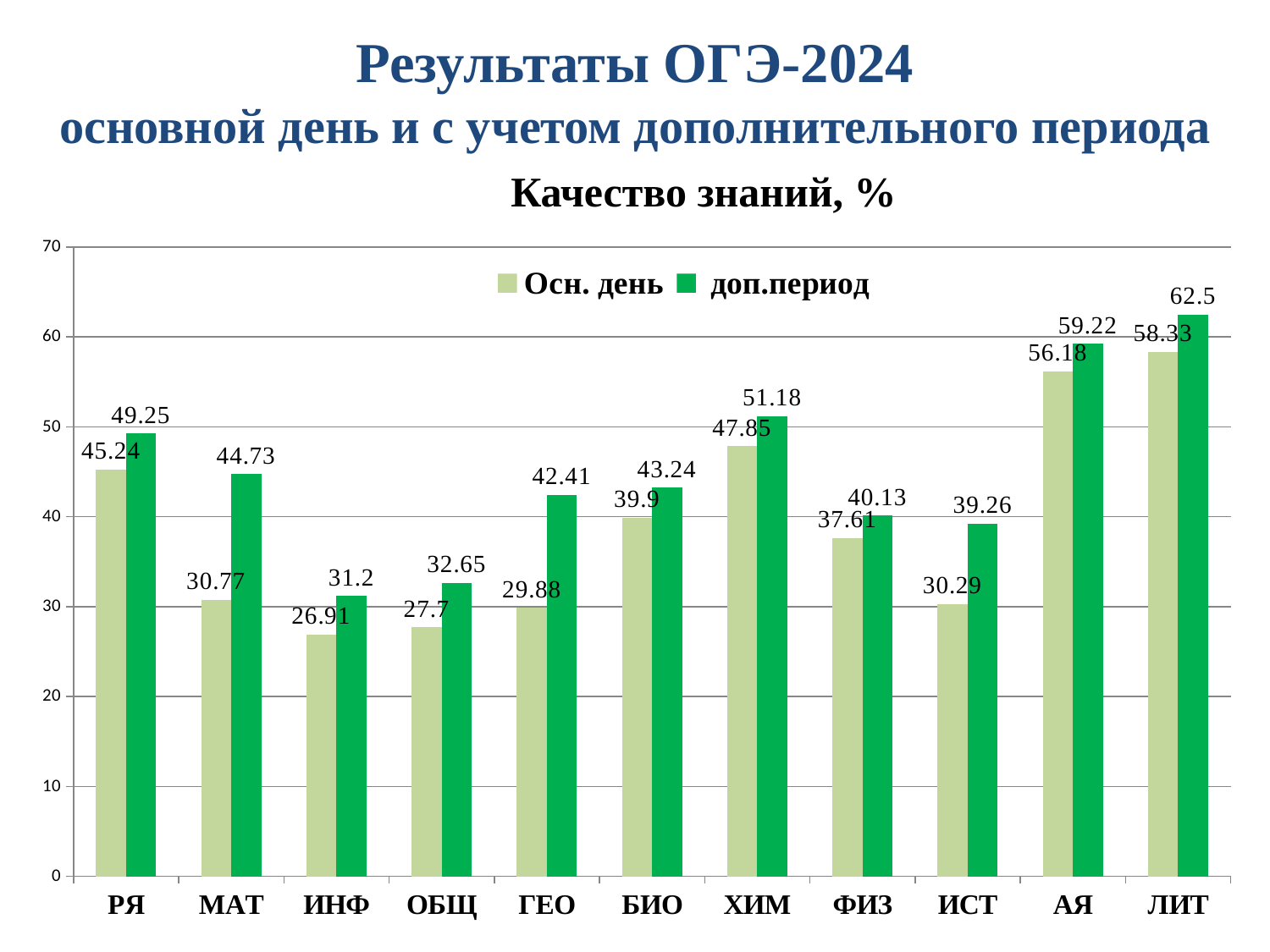
What is the value for ГЕО in the Осн. день series? 29.88 Which category has the highest value in the доп.период series? ЛИТ Is the доп.период value for ФИЗ greater or less than 40? greater Which is larger: the Осн. день value for ХИМ or the Осн. день value for БИО? ХИМ What kind of chart is shown on the slide? bar chart What is the value for МАТ in the доп.период series? 44.73 What is the difference between the доп.период and Осн. день values for МАТ? 13.96 Which category has the lowest value in the Осн. день series? ИНФ How many categories are shown on the x axis? 11 How many series does the legend list? 2 What is the value for ИСТ in the доп.период series? 39.26 What is the difference between the доп.период and Осн. день values for ЛИТ? 4.17